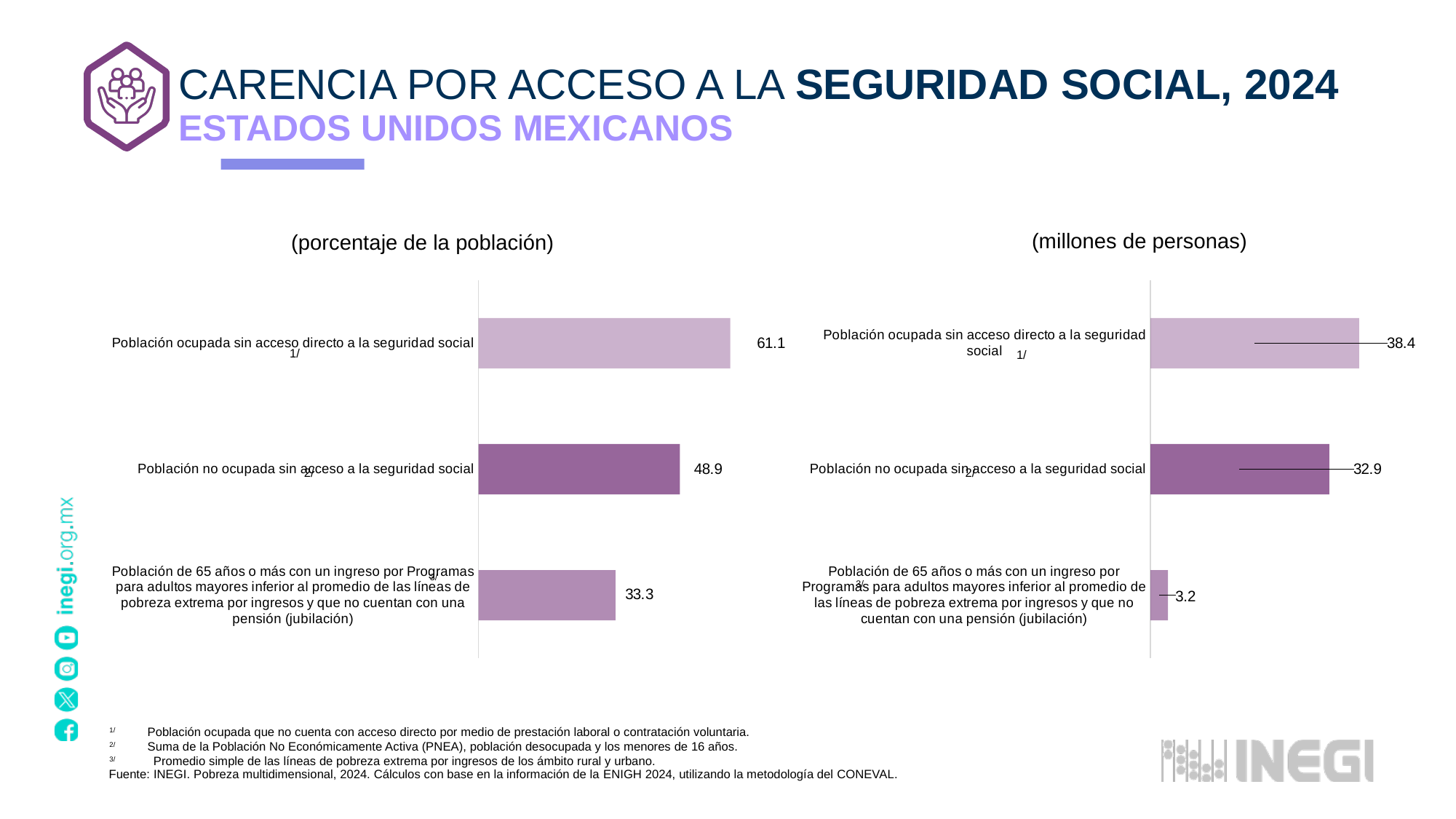
How many categories does the left chart (porcentaje de la población) show? 3 In the left chart (porcentaje de la población), what is the value for Población de 65 años o más con un ingreso por Programas para adultos mayores inferior al promedio de las líneas de pobreza extrema? 33.3 In the right chart (millones de personas), what is the value for Población no ocupada sin acceso a la seguridad social? 32.9 In the right chart (millones de personas), what is the difference between Población ocupada sin acceso directo a la seguridad social and Población no ocupada sin acceso a la seguridad social? 5.5 In the right chart (millones de personas), which category has the lowest value? Población de 65 años o más con un ingreso por Programas para adultos mayores inferior al promedio de las líneas de pobreza extrema por ingresos y que no cuentan con una pensión (jubilación) In the right chart (millones de personas), what is the value for Población ocupada sin acceso directo a la seguridad social? 38.4 In the left chart (porcentaje de la población), what is the value for Población ocupada sin acceso directo a la seguridad social? 61.1 In the right chart (millones de personas), what is the value for Población de 65 años o más con un ingreso por Programas para adultos mayores inferior al promedio de las líneas de pobreza extrema? 3.2 In the left chart (porcentaje de la población), what is the difference between Población ocupada sin acceso directo a la seguridad social and Población no ocupada sin acceso a la seguridad social? 12.2 In the left chart (porcentaje de la población), which category has the highest value? Población ocupada sin acceso directo a la seguridad social What kind of chart is the right chart (millones de personas)? Bar chart In the left chart (porcentaje de la población), what is the value for Población no ocupada sin acceso a la seguridad social? 48.9